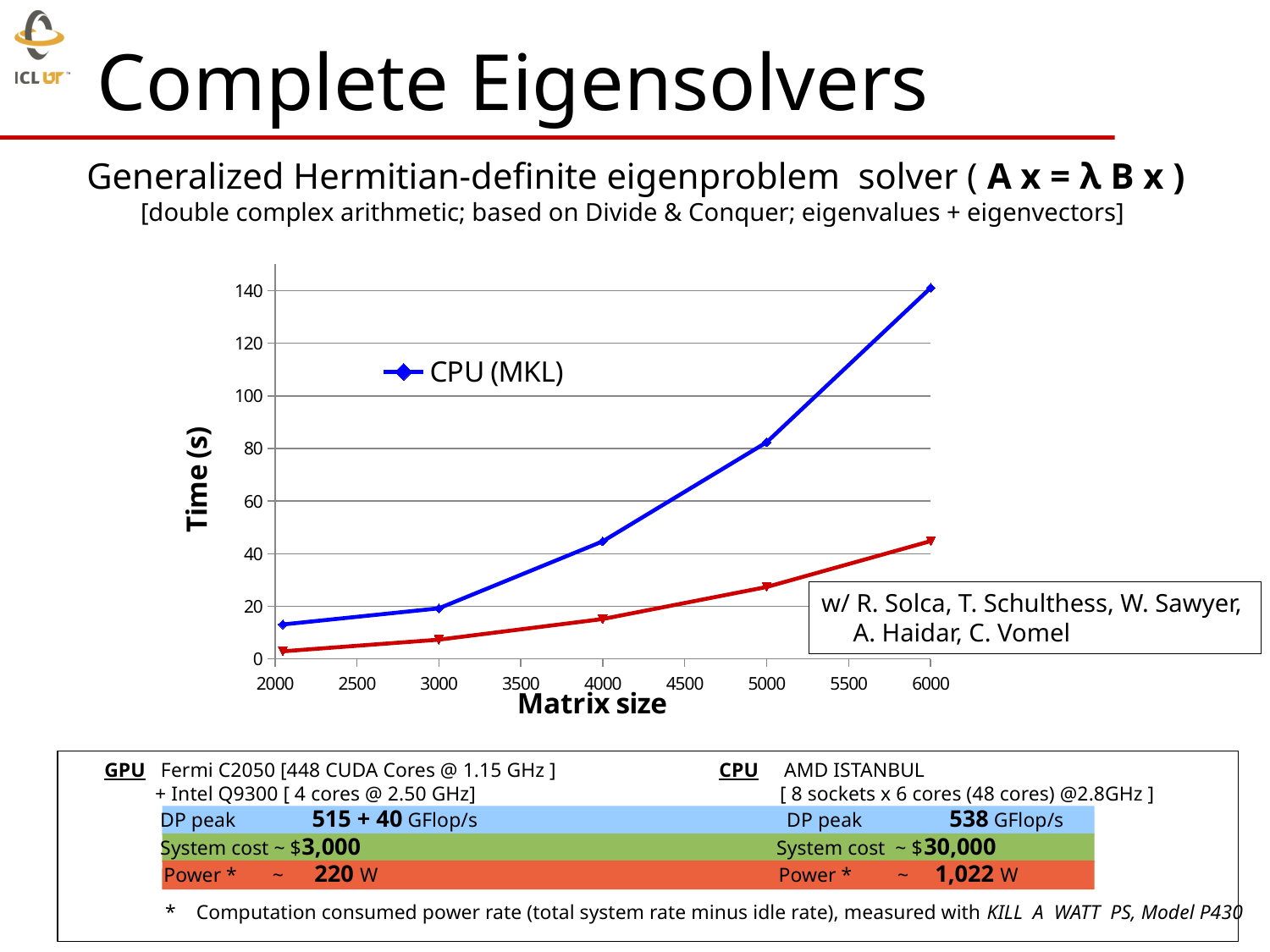
What kind of chart is shown on the slide? line chart At matrix size 6000, which line shows the larger time, the blue CPU (MKL) line or the red line? the blue CPU (MKL) line Does the CPU (MKL) time rise or fall as matrix size increases? rise How many data points does the CPU (MKL) line have? 5 Is the CPU (MKL) time at matrix size 6000 greater or less than 120? greater At which matrix size is the CPU (MKL) time lowest? 2000 Is the CPU (MKL) time at matrix size 5000 greater or less than 60? greater At which matrix size is the CPU (MKL) time highest? 6000 Is the CPU (MKL) time at matrix size 4000 greater or less than 60? less What is the label of the chart's y axis? Time (s) Which series is named in the chart's legend? CPU (MKL)